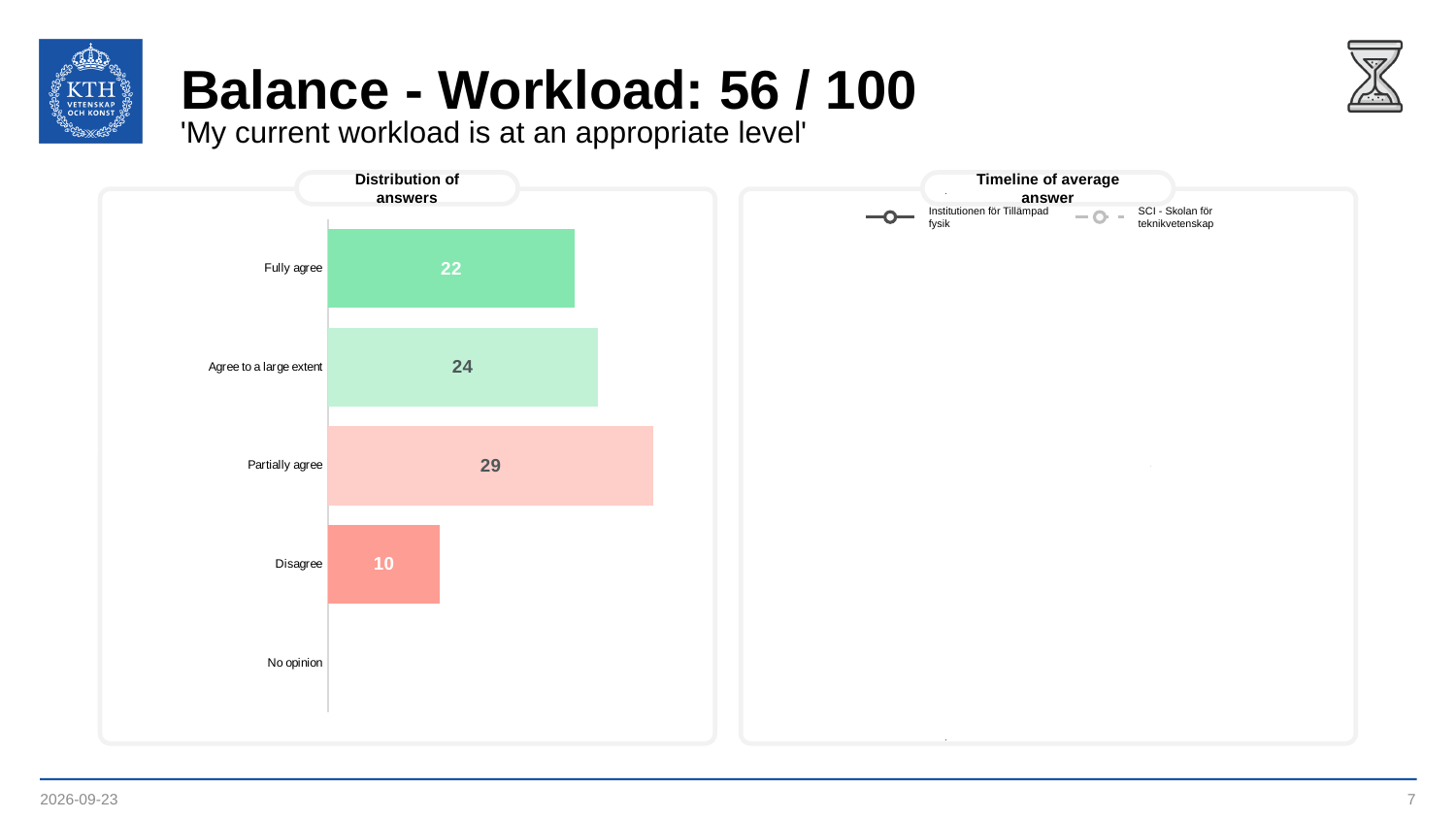
In the 'Distribution of answers' chart, what is the value for 'Disagree'? 10 In the 'Distribution of answers' chart, which is larger: the value for 'Fully agree' or the value for 'Agree to a large extent'? Agree to a large extent In the 'Distribution of answers' chart, which category has the highest value? Partially agree What is the title of the chart on the left side of the slide? Distribution of answers In the 'Distribution of answers' chart, which category with a visible bar has the lowest value? Disagree In the 'Distribution of answers' chart, what is the value for 'Agree to a large extent'? 24 What kind of chart is the 'Distribution of answers' chart? Bar chart How many categories are listed on the 'Distribution of answers' chart? 5 In the 'Distribution of answers' chart, what is the difference between the values for 'Partially agree' and 'Disagree'? 19 In the 'Distribution of answers' chart, what is the value for 'Partially agree'? 29 How many series does the legend of the 'Timeline of average answer' chart list? 2 In the 'Distribution of answers' chart, what is the value for 'Fully agree'? 22